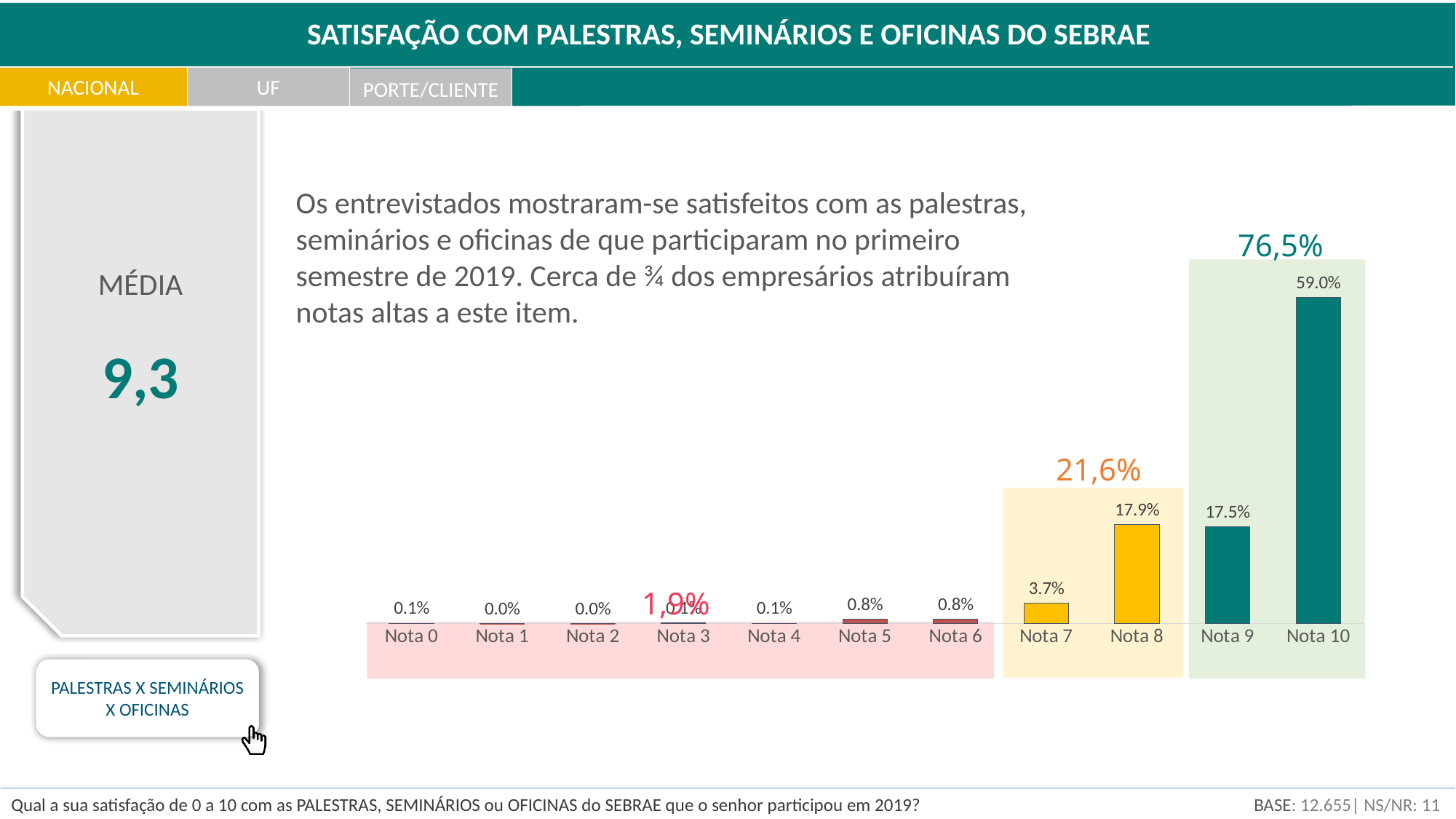
What is the value for Nota 8? 17.9% What is the value for Nota 9? 17.5% What is the difference between the values for Nota 8 and Nota 7? 14.2% How many categories (Nota 0 to Nota 10) are shown on the x axis? 11 What combined percentage is shown above the group containing Nota 9 and Nota 10? 76,5% What is the value for Nota 10? 59.0% Which is larger, the value for Nota 7 or the value for Nota 9? Nota 9 What is the value for Nota 7? 3.7% What is the difference between the values for Nota 10 and Nota 8? 41.1% What kind of chart is shown on the slide? Bar chart What combined percentage is shown above the group containing Nota 7 and Nota 8? 21,6% Which category has the highest value? Nota 10